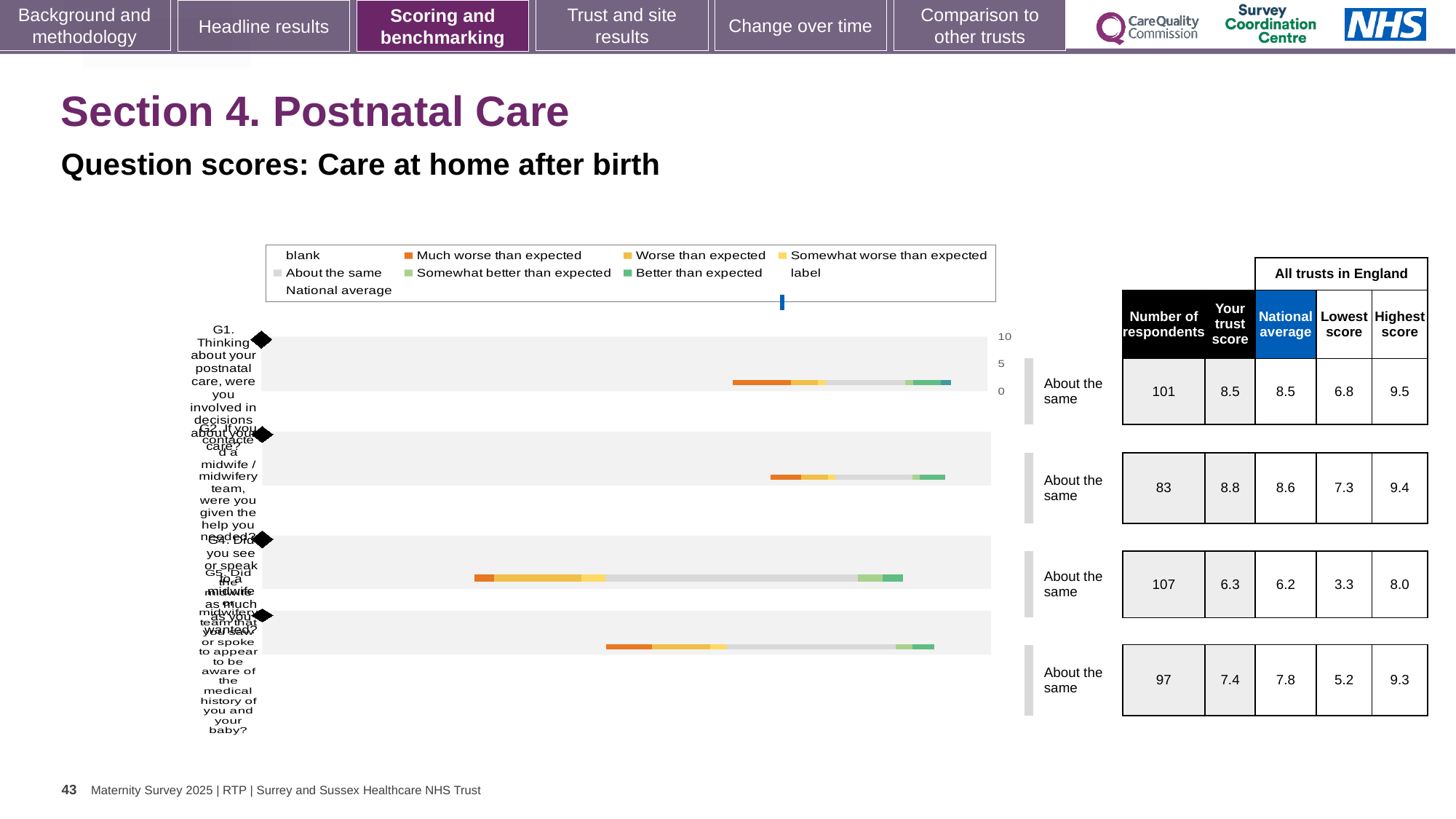
What colour does the legend use for 'Much worse than expected'? orange What kind of chart is shown on the slide? bar chart In the table next to the chart, which question has the lowest 'Your trust score'? G4 In the table next to the chart, what is the difference between the highest score and the lowest score for question G4? 4.7 How many question bars are plotted in the chart? 4 In the table next to the chart, is 'Your trust score' for G5 larger or smaller than the national average for G5? smaller In the table next to the chart, what is the national average for question G4? 6.2 How many entries does the chart legend list? 9 What colour does the legend use for 'Better than expected'? green In the table next to the chart, what is 'Your trust score' for question G2? 8.8 In the table next to the chart, what is the number of respondents for question G1? 101 In the table next to the chart, what is the highest score for question G5? 9.3